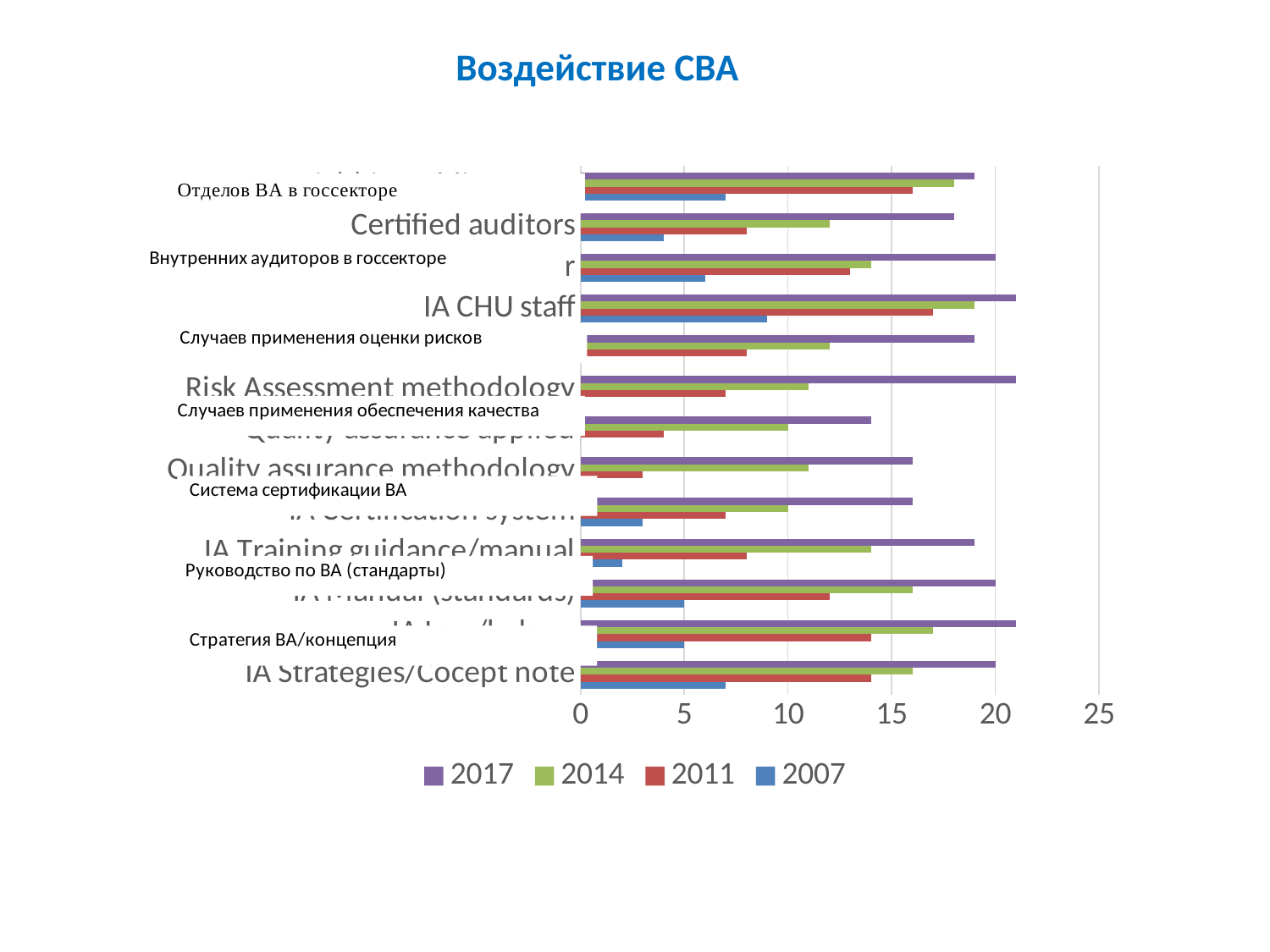
Is the 2017 value for IA Strategies/Cocept note greater or less than 15? greater Is the 2007 value for Certified auditors greater or less than 5? less Is the 2011 value for IA CHU staff greater or less than 15? greater For IA CHU staff, which year has the longest bar? 2017 How many series does the legend list? 4 What kind of chart is shown on the slide? bar chart What is the title of the slide above the chart? Воздействие СВА Which years are listed in the chart legend? 2017, 2014, 2011, 2007 For Certified auditors, which is larger: the 2017 value or the 2007 value? 2017